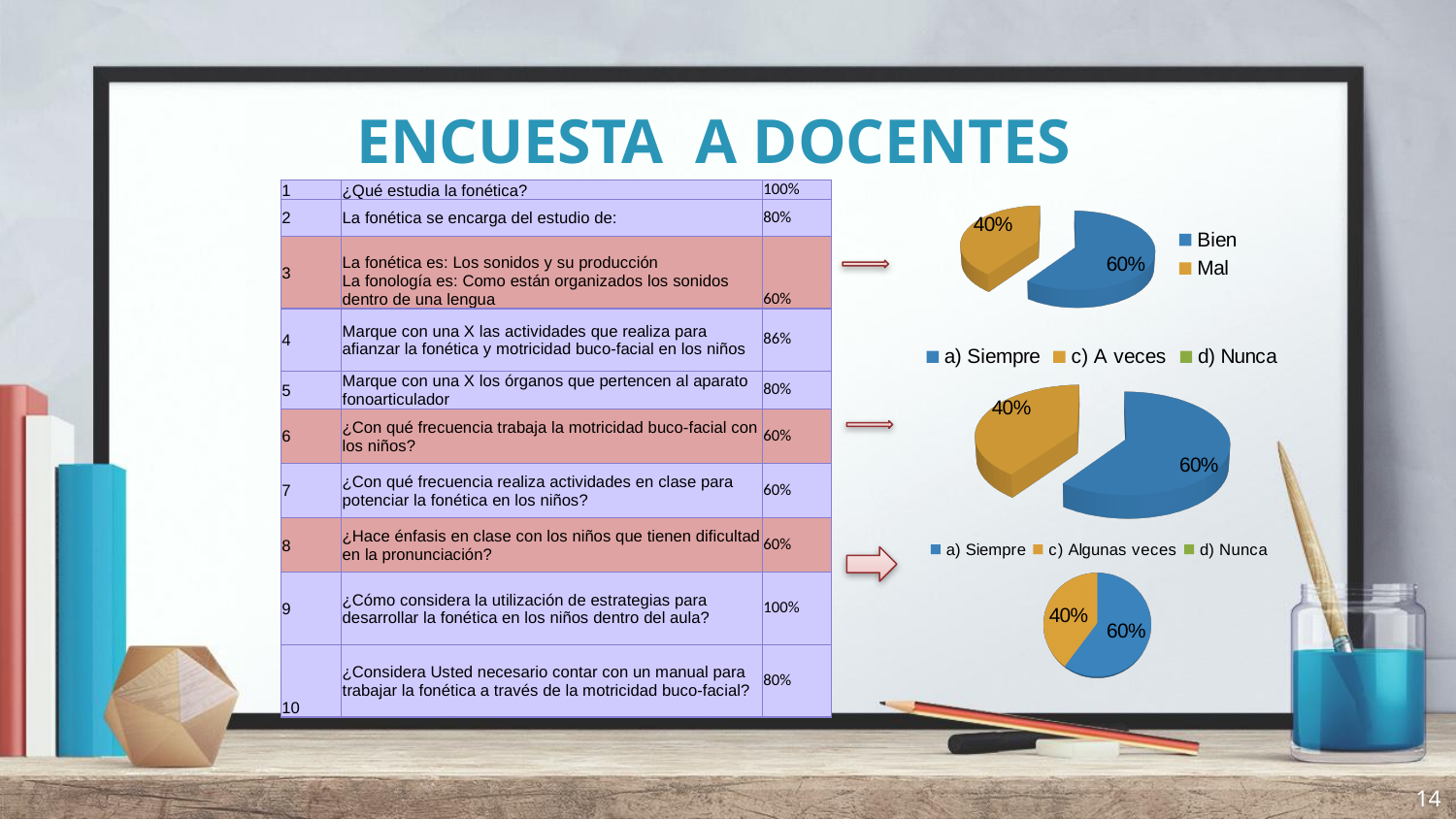
How many entries does the legend of the middle pie chart list? 3 In the top pie chart, what share is labelled for 'Bien'? 60% In the bottom pie chart, what share is labelled for 'c) Algunas veces'? 40% What kind of chart is the top chart on the right side of the slide? pie chart In the middle pie chart, what share is labelled for 'c) A veces'? 40% In the bottom pie chart, which category has the largest slice? a) Siempre In the top pie chart, what share is labelled for 'Mal'? 40% In the middle pie chart, what is the difference between the 'a) Siempre' and 'c) A veces' shares? 20% What is the third legend entry of the bottom pie chart? d) Nunca How many entries does the legend of the top pie chart list? 2 In the top pie chart, which category has the larger slice, 'Bien' or 'Mal'? Bien In the middle pie chart, what share is labelled for 'a) Siempre'? 60%